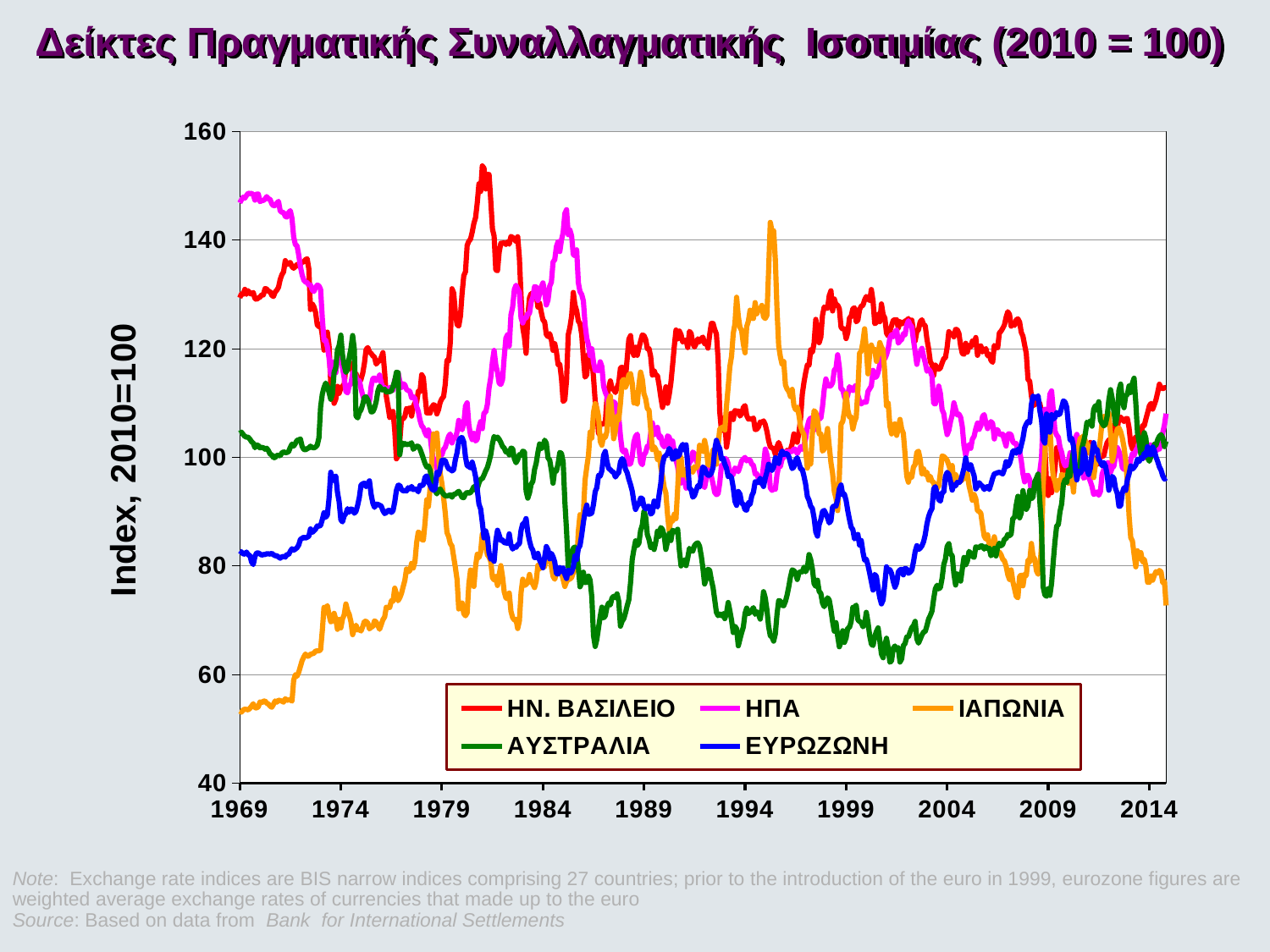
Is the value for ΗΠΑ in 1969 greater or less than 140? greater Is the value for ΗΝ. ΒΑΣΙΛΕΙΟ in 1969 greater or less than 120? greater Does the ΙΑΠΩΝΙΑ series rise or fall overall between 1969 and 1995? rise How many series does the legend list? 5 What is the label on the vertical axis of the chart? Index, 2010=100 Which series has the highest value in 1969? ΗΠΑ Is the value for ΙΑΠΩΝΙΑ in 1969 greater or less than 60? less Which series has the lowest value in 1969? ΙΑΠΩΝΙΑ What kind of chart is shown on the slide? line chart Which series is drawn in orange in the chart? ΙΑΠΩΝΙΑ In 1969, which is higher: ΗΠΑ or ΕΥΡΩΖΩΝΗ? ΗΠΑ